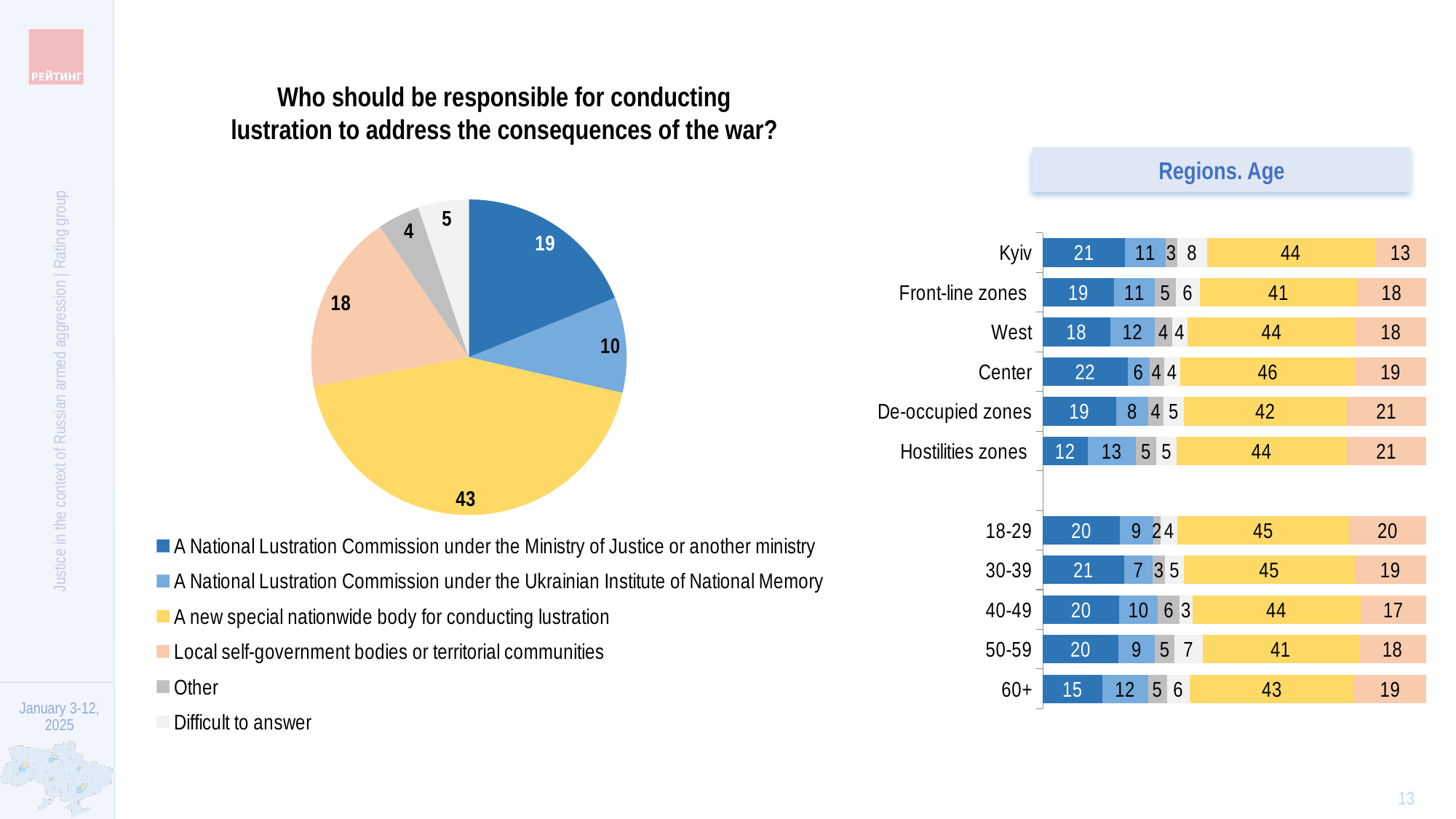
In the 'Regions. Age' chart, what is the value for the dark blue segment (Ministry of Justice commission) for Hostilities zones? 12 What kind of chart is the chart on the left of the slide? Pie chart In the 'Regions. Age' chart, what is the value for the yellow segment (new special nationwide body) for Center? 46 In the 'Regions. Age' chart, is the value for the peach segment (local self-government bodies) larger for Kyiv or for De-occupied zones? De-occupied zones In the pie chart, what share chose 'A new special nationwide body for conducting lustration'? 43 In the pie chart, which option has the smallest share? Other In the 'Regions. Age' chart, what is the difference between the yellow segment values for 18-29 and 50-59? 4 In the 'Regions. Age' chart, which region has the highest value for the yellow segment (new special nationwide body)? Center In the pie chart, what is the difference between the share for 'A National Lustration Commission under the Ministry of Justice or another ministry' and the share for 'A National Lustration Commission under the Ukrainian Institute of National Memory'? 9 In the pie chart, which option has the largest share? A new special nationwide body for conducting lustration How many categories does the pie chart legend list? 6 What kind of chart is the 'Regions. Age' chart? Stacked bar chart